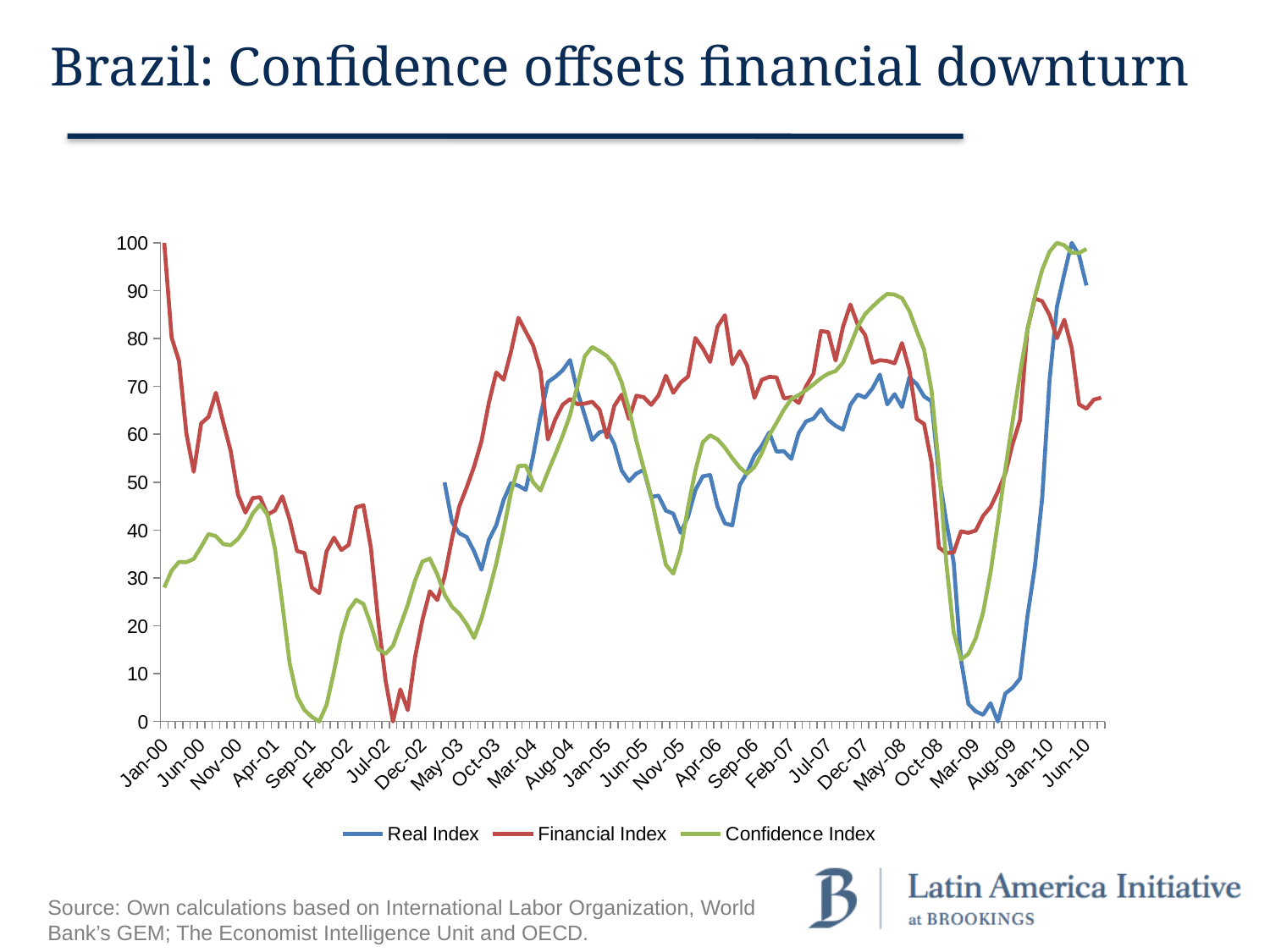
Around Aug-09, which is larger: the Confidence Index or the Real Index? Confidence Index Is the value of the Confidence Index around Sep-01 greater or less than 10? less Does the Real Index rise or fall between Mar-09 and Jan-10? rise How many series does the legend list? 3 Does the Financial Index rise or fall between Jan-00 and Sep-01? fall Is the value of the Real Index around Mar-09 greater or less than 10? less What is the title of the slide containing the chart? Brazil: Confidence offsets financial downturn Which colour is used for the Confidence Index line? green What kind of chart is shown on the slide? line chart Is the value of the Financial Index at Jan-00 greater or less than 90? greater At Jan-00, which is larger: the Financial Index or the Confidence Index? Financial Index